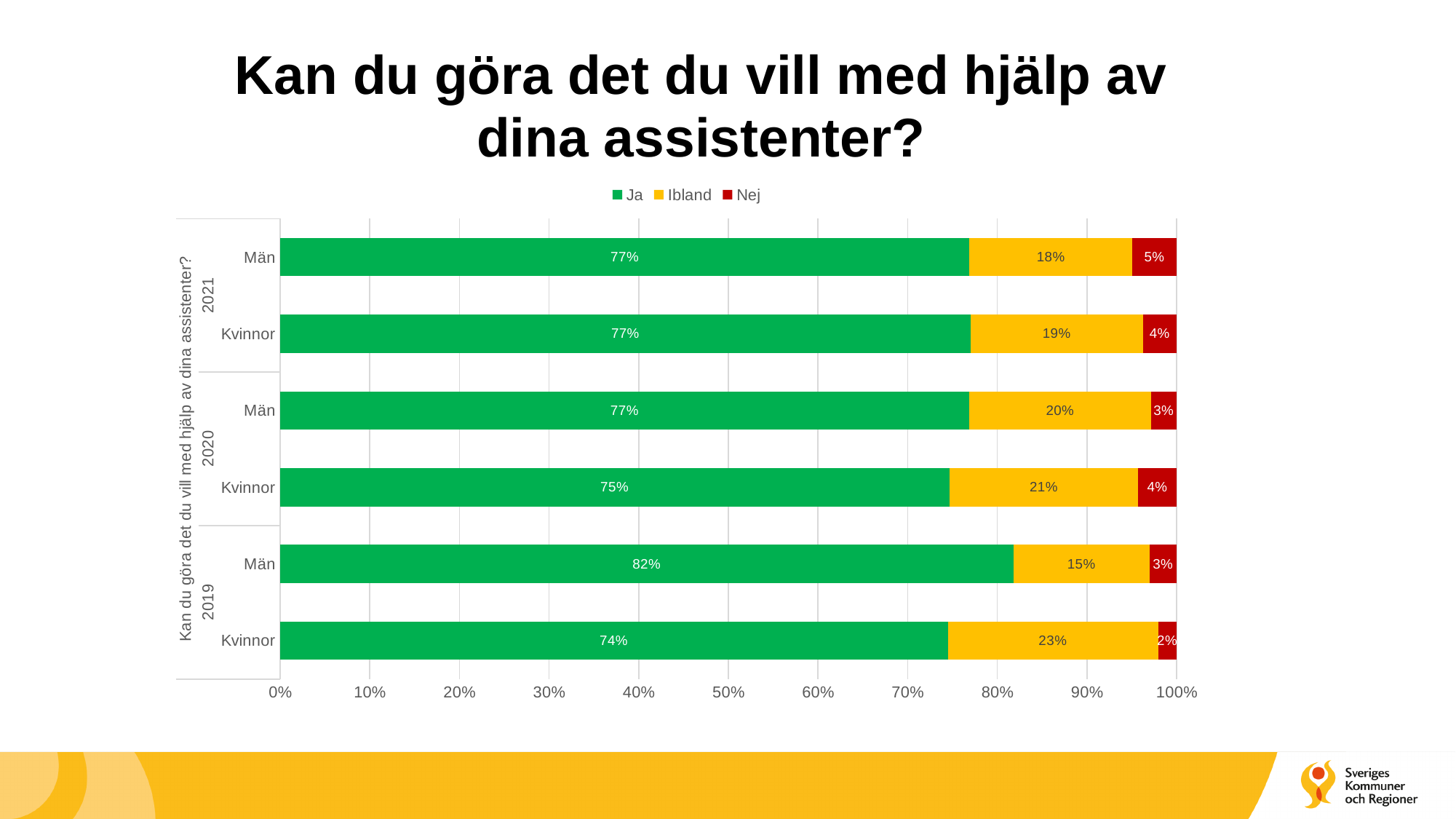
What is the "Ja" value for women (Kvinnor) in 2020? 75% What type of chart is shown on the slide? Stacked bar chart Which group has the highest "Ja" share? Män 2019 What is the "Ibland" value for women (Kvinnor) in 2019? 23% What colour represents the "Nej" series? Red How many series does the legend list? 3 How many bars (groups) are shown in the chart? 6 What percentage of men in 2019 answered "Ja"? 82% What is the "Nej" value for men (Män) in 2021? 5% Which group has the lowest "Nej" share? Kvinnor 2019 What is the difference between the "Ja" values for men and women in 2019? 8 percentage points Which is larger: the "Ibland" value for women in 2020 or for men in 2020? Kvinnor 2020